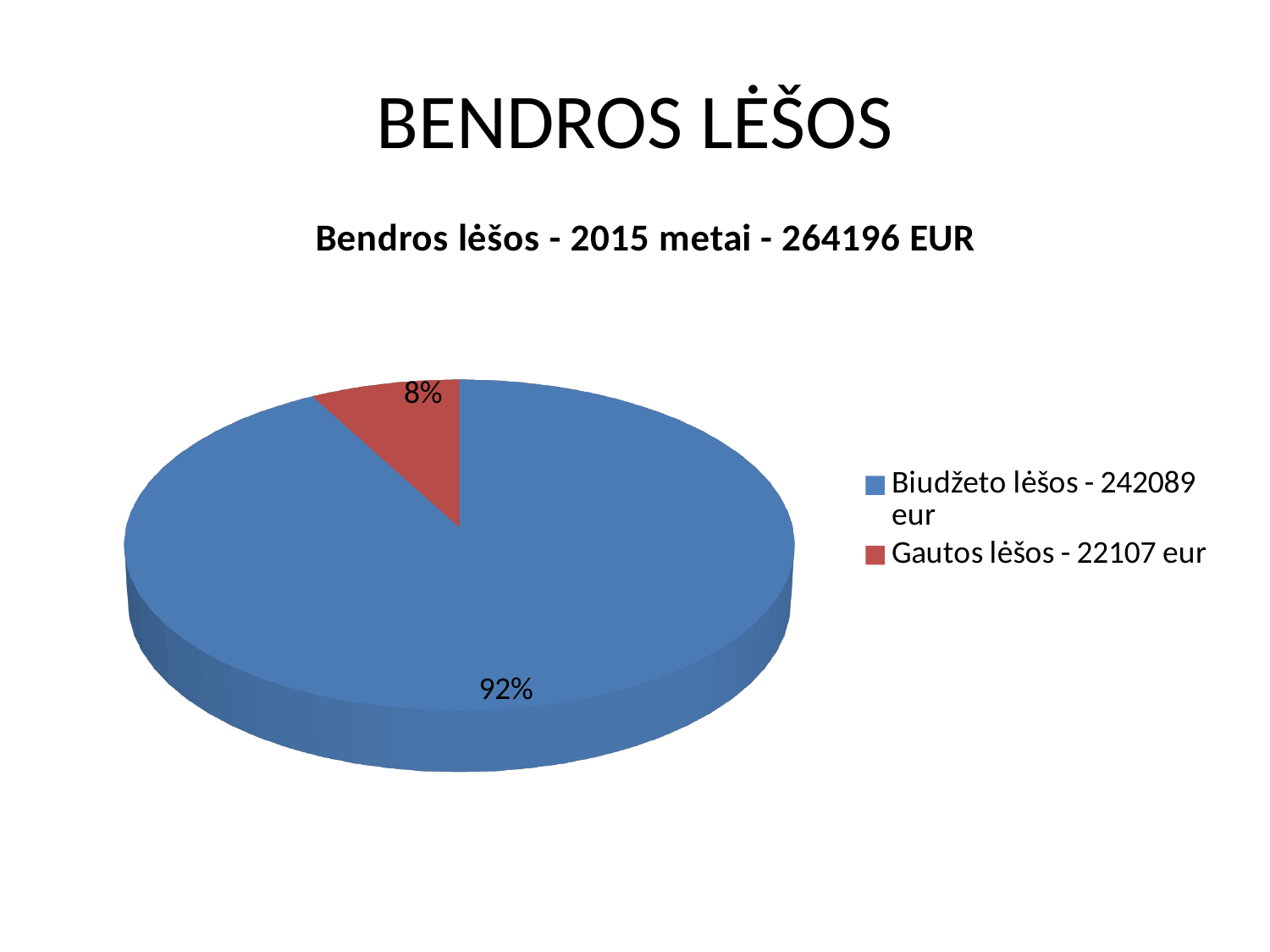
How many entries does the legend list? 2 Which slice is the smallest in the pie chart? Gautos lėšos - 22107 eur What share of the pie does the slice for "Biudžeto lėšos - 242089 eur" represent? 92% What is the difference in percentage points between the "Biudžeto lėšos" slice and the "Gautos lėšos" slice? 84 percentage points What kind of chart is shown on the slide? pie chart What colour is the slice for "Gautos lėšos - 22107 eur"? red What share of the pie does the slice for "Gautos lėšos - 22107 eur" represent? 8% How many slices does the pie chart have? 2 Which is larger: the share for "Biudžeto lėšos" or the share for "Gautos lėšos"? Biudžeto lėšos Which slice is the largest in the pie chart? Biudžeto lėšos - 242089 eur What is the title of the chart? Bendros lėšos - 2015 metai - 264196 EUR